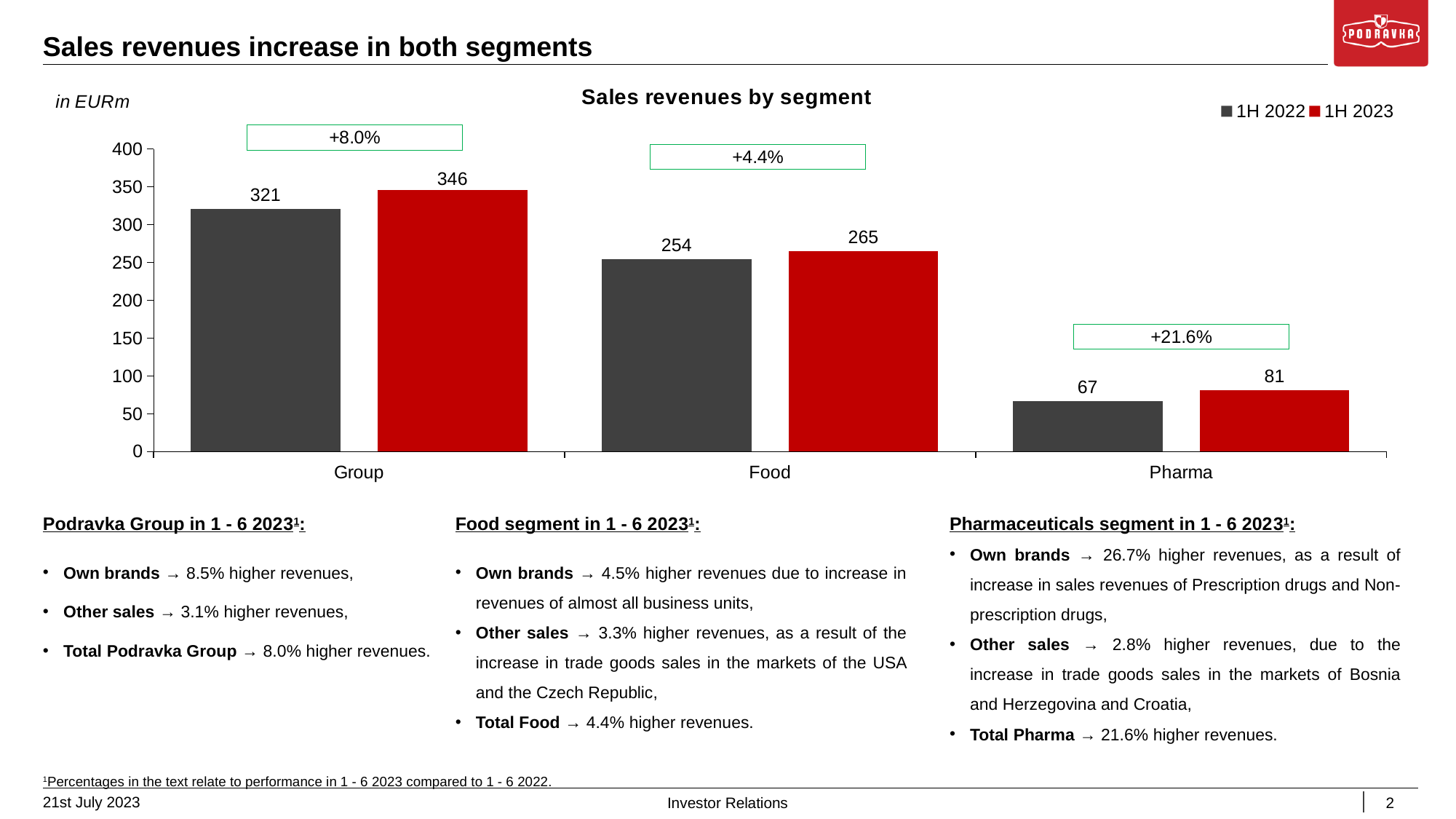
What is the 1H 2023 sales revenue for the Food segment? 265 How many categories are shown on the x axis? 3 Which category has the lowest 1H 2022 value? Pharma Which is larger for Food: the 1H 2022 value or the 1H 2023 value? 1H 2023 Is the 1H 2023 value for Pharma greater or less than 100? less Which category has the highest 1H 2023 value? Group What is the 1H 2022 sales revenue for Pharma? 67 How many series does the legend list? 2 What percentage change is shown above the Pharma bars? +21.6% What kind of chart is shown on the slide? bar chart What is the title of the chart? Sales revenues by segment What is the difference between the 1H 2023 and 1H 2022 values for Group? 25